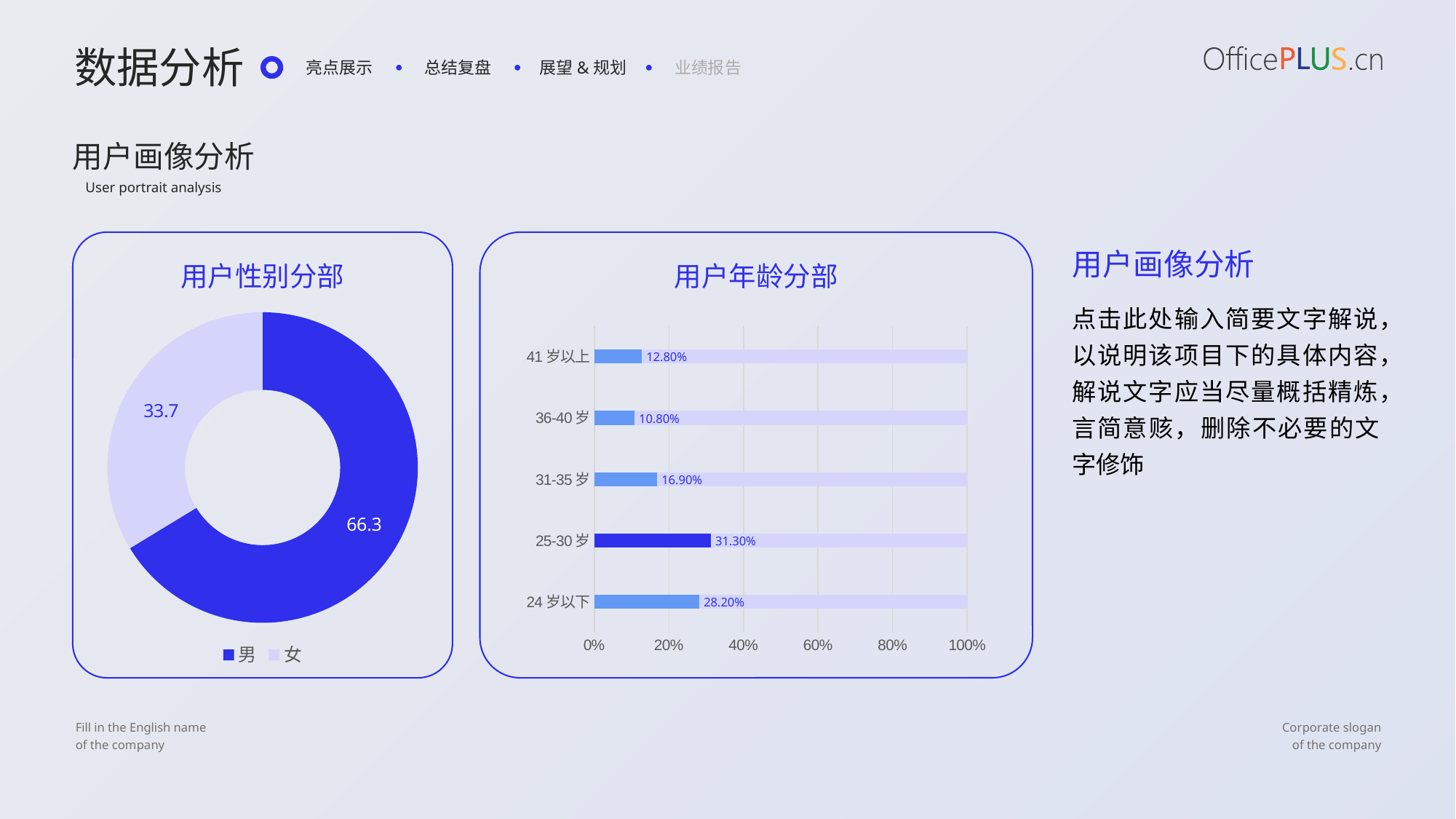
In the 用户性别分部 chart, what is the value for 女? 33.7 In the 用户年龄分部 chart, what is the value for 36-40 岁? 10.80% How many age groups are shown in the 用户年龄分部 chart? 5 In the 用户年龄分部 chart, which age group has the lowest value? 36-40 岁 In the 用户年龄分部 chart, which age group has the highest value? 25-30 岁 In the 用户性别分部 chart, which category has the larger share, 男 or 女? 男 In the 用户年龄分部 chart, what is the difference between the values for 25-30 岁 and 24 岁以下? 3.10% How many entries does the legend of the 用户性别分部 chart list? 2 In the 用户性别分部 chart, what is the difference between the values for 男 and 女? 32.6 In the 用户年龄分部 chart, what is the value for 25-30 岁? 31.30% In the 用户性别分部 chart, what is the value for 男? 66.3 What kind of chart is the 用户性别分部 chart? Doughnut chart